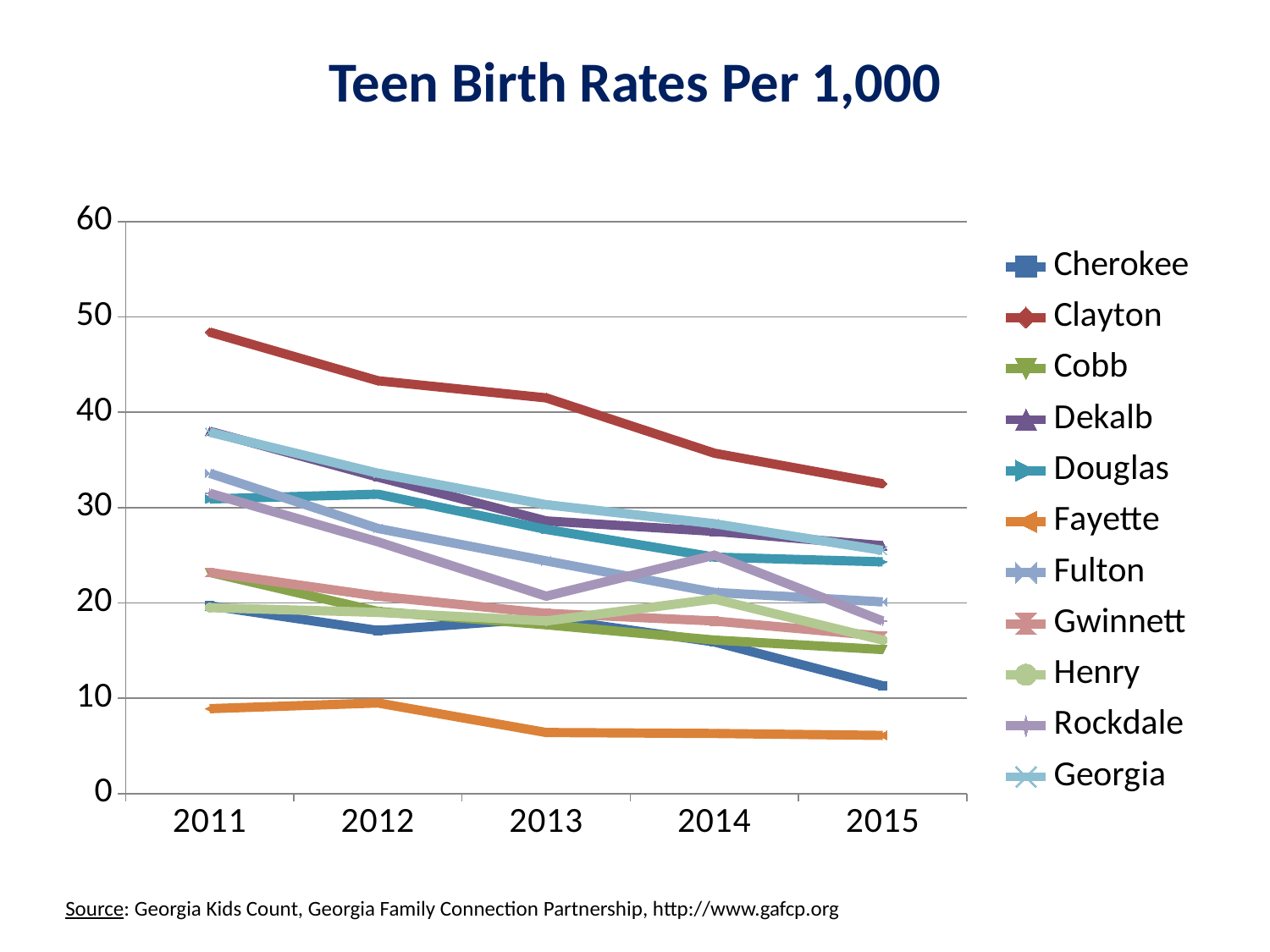
Which series is shown in orange in the legend? Fayette Which county has the lowest teen birth rate in 2015? Fayette What kind of chart is shown on the slide? line chart What is the title of the chart? Teen Birth Rates Per 1,000 Which is larger in 2015, the value for Clayton or the value for Cherokee? Clayton Which county has the highest teen birth rate in 2011? Clayton How many series does the legend list? 11 How many years are shown along the x axis? 5 Is the value for Clayton in 2011 greater or less than 40? greater Does the Clayton line rise or fall from 2011 to 2015? fall Is the value for Fayette in 2013 greater or less than 10? less Is the value for Cherokee in 2015 greater or less than 20? less